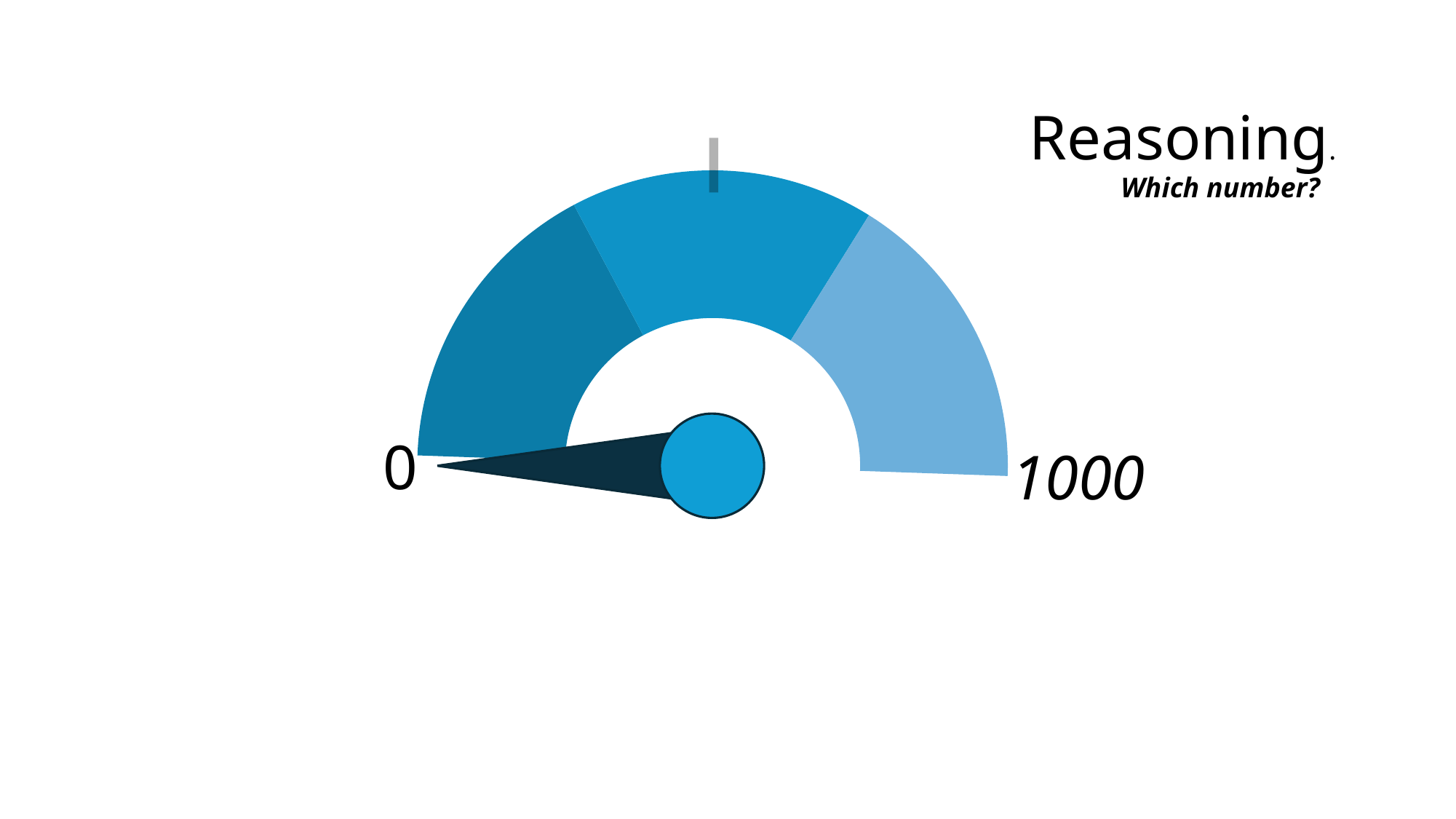
What kind of chart is shown on the slide? gauge chart Is the value the needle points to greater or less than 1000? less Is the needle closer to the 0 end or the 1000 end of the gauge? 0 What is the highest value labelled on the gauge scale? 1000 What question is written under the chart title? Which number? What is the lowest value labelled on the gauge scale? 0 What is the title of the chart? Reasoning. What value does the needle point to? 0 How many coloured segments does the gauge arc have? 3